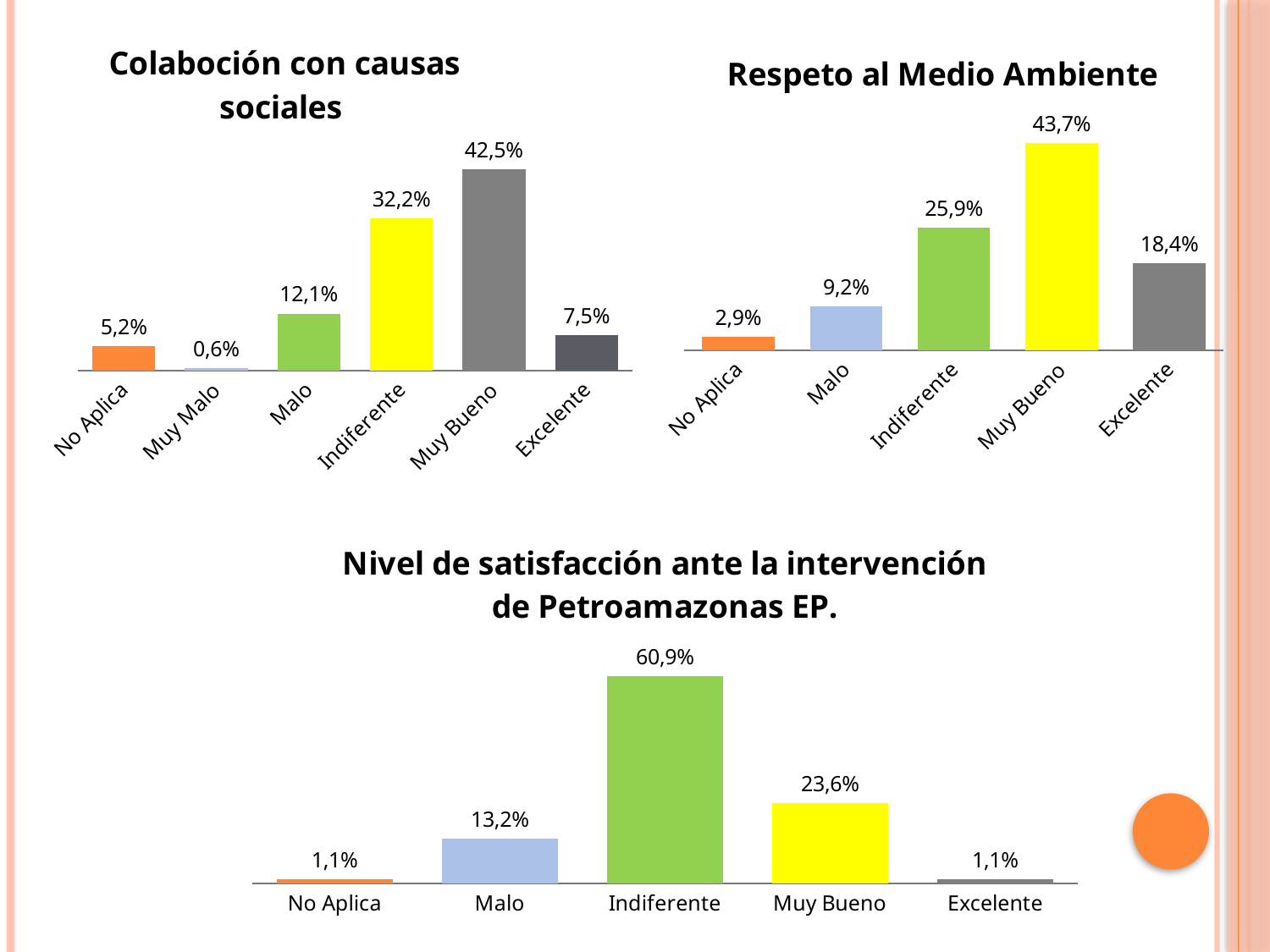
In the 'Nivel de satisfacción ante la intervención de Petroamazonas EP.' chart, what is the difference between Muy Bueno and Malo? 10,4% In the 'Nivel de satisfacción ante la intervención de Petroamazonas EP.' chart, what is the value for Indiferente? 60,9% In the 'Nivel de satisfacción ante la intervención de Petroamazonas EP.' chart, what colour is the Indiferente bar? Green In the 'Respeto al Medio Ambiente' chart, which is larger, Malo or No Aplica? Malo In the 'Colaboción con causas sociales' chart, which category has the lowest value? Muy Malo In the 'Respeto al Medio Ambiente' chart, what is the difference between Muy Bueno and Indiferente? 17,8% In the 'Respeto al Medio Ambiente' chart, what is the value for Excelente? 18,4% In the 'Colaboción con causas sociales' chart, how many categories are shown? 6 In the 'Colaboción con causas sociales' chart, what is the value for Indiferente? 32,2% In the 'Colaboción con causas sociales' chart, which category has the highest value? Muy Bueno What kind of chart is the 'Nivel de satisfacción ante la intervención de Petroamazonas EP.' chart? Bar chart In the 'Respeto al Medio Ambiente' chart, how many categories are shown? 5